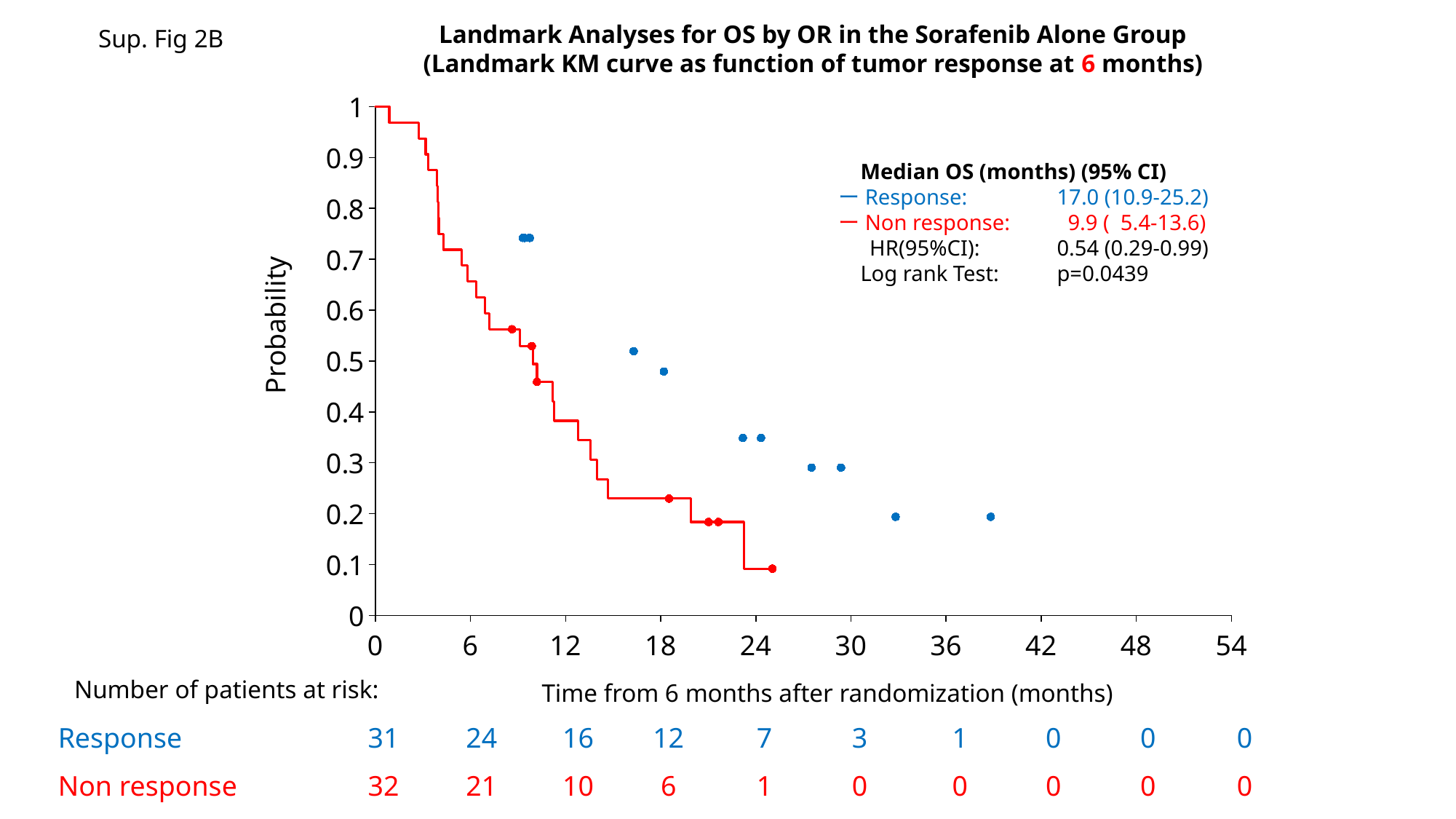
How many Non response patients are at risk at 18 months in the number-at-risk table? 6 Is the survival probability of the Non response curve at 18 months greater or less than 0.3? less What is the difference between the number of Response and Non response patients at risk at 6 months? 3 What is the log rank test p-value shown on the chart? p=0.0439 How many Response patients are at risk at time 0 in the number-at-risk table? 31 How many groups does the legend list? 2 What is the median OS (months) with 95% CI for the Response group? 17.0 (10.9-25.2) Does the Non response survival probability rise or fall as time increases along the x axis? fall Which group has the higher median OS, Response or Non response? Response What colour is used for the Non response group? Red What is the hazard ratio with 95% CI shown on the chart? 0.54 (0.29-0.99) What is the median OS in months for the Non response group? 9.9